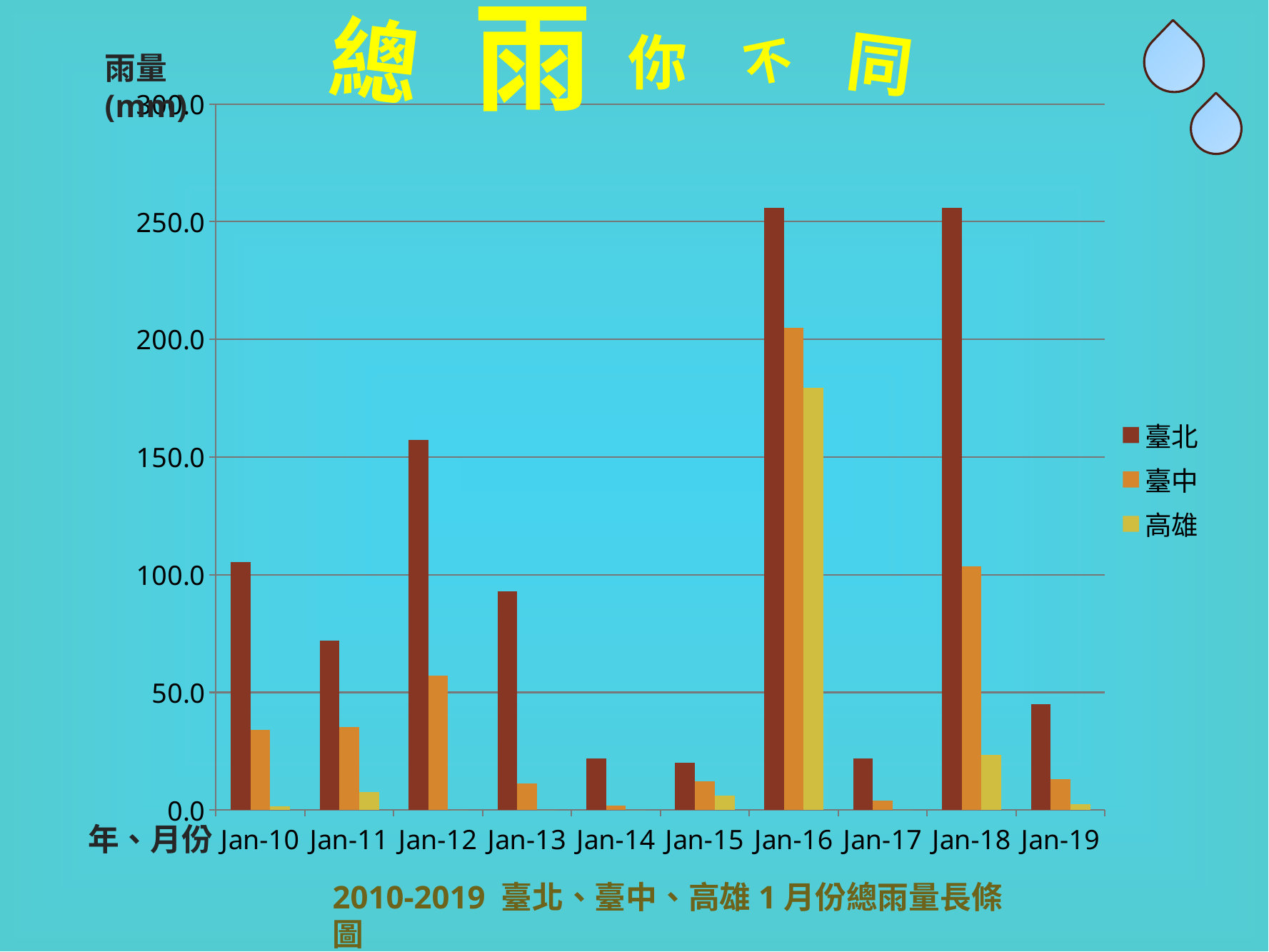
In which month is the 高雄 bar the highest? Jan-16 Is the value for 高雄 in Jan-16 greater or less than 150? greater Which is larger, the 臺北 value in Jan-11 or in Jan-13? Jan-13 Which series has the tallest bar in Jan-16? 臺北 In which month is the 臺中 bar the highest? Jan-16 What kind of chart is shown on the slide? bar chart Is the value for 臺北 in Jan-16 greater or less than 200? greater How many series does the legend list? 3 Do the 臺北 values rise or fall from Jan-12 to Jan-14? fall Is the value for 臺北 in Jan-14 greater or less than 50? less Which series is shown in dark red-brown bars? 臺北 How many categories (months) are shown on the x axis? 10